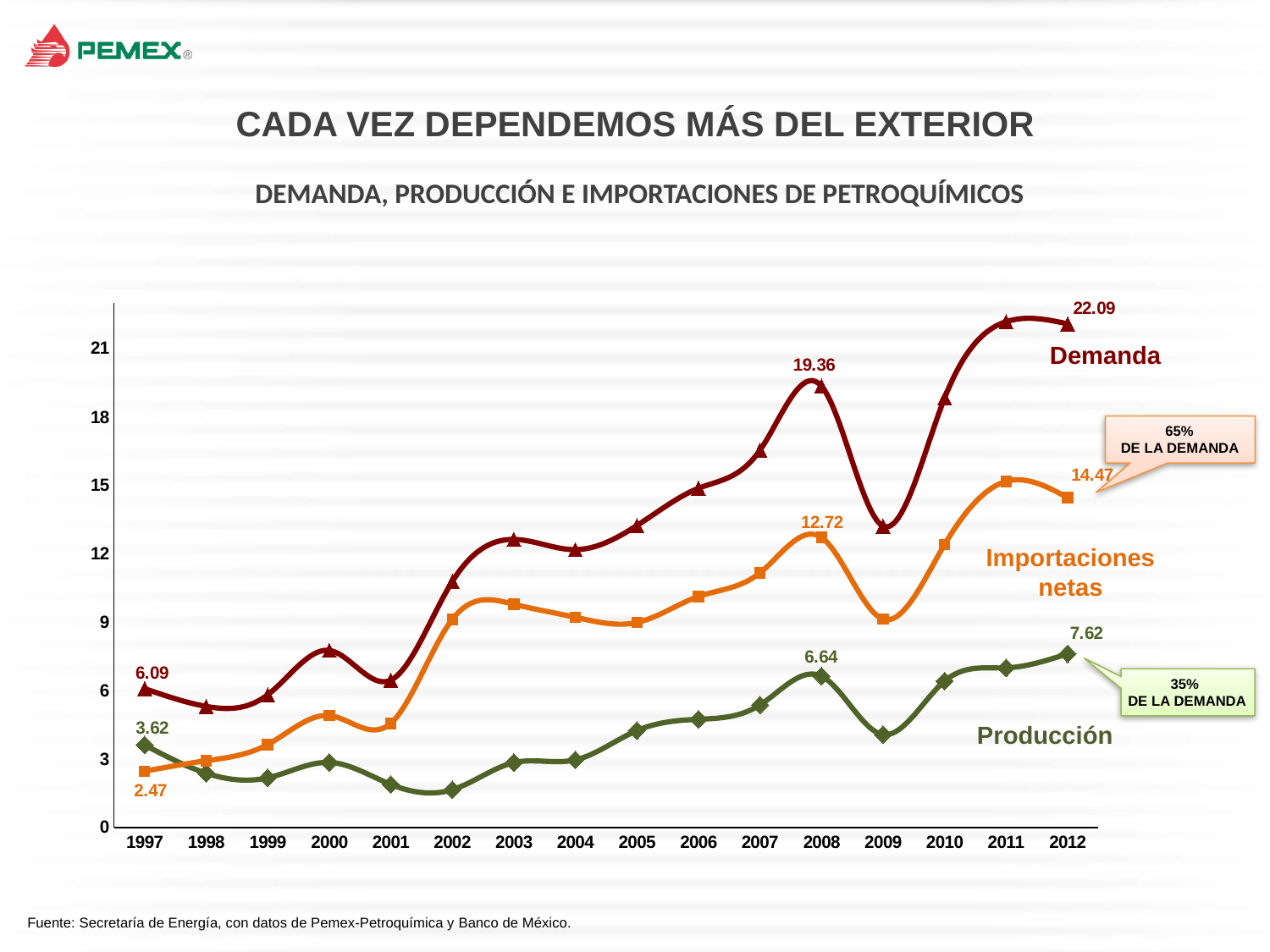
What is the value of Demanda in 2008? 19.36 What type of chart is shown on the slide? Line chart Is the value of Demanda in 2010 greater or less than 18? greater Which is larger in 1997, Producción or Importaciones netas? Producción Which series has the highest value in 2012? Demanda What is the value of Demanda in 2012? 22.09 What is the value of Producción in 2008? 6.64 What is the difference between Demanda and Producción in 2012? 14.47 What is the value of Importaciones netas in 1997? 2.47 By how much did Producción grow from 1997 to 2012? 4.00 How many years are shown on the x axis? 16 How many series are plotted on the chart? 3